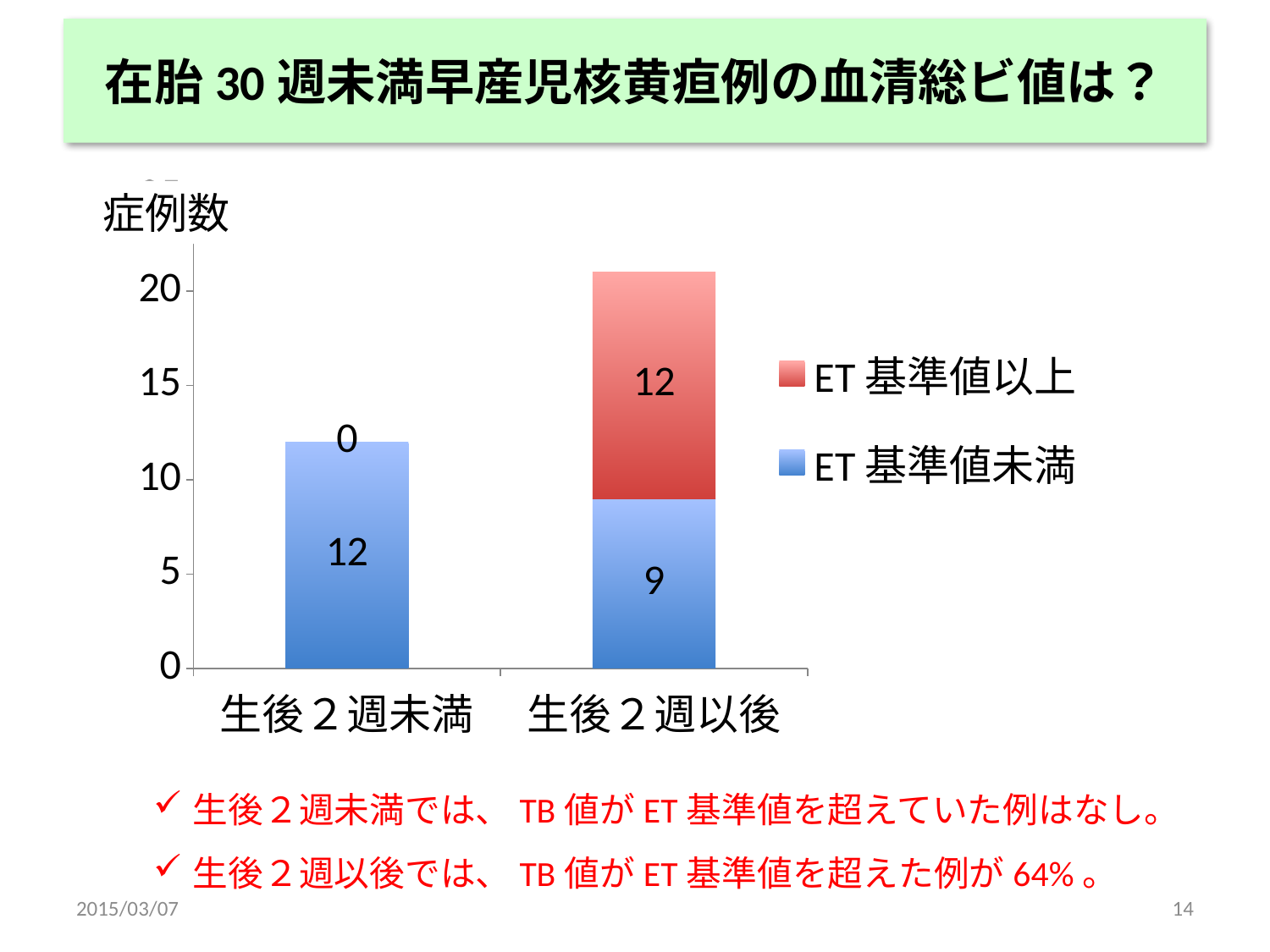
What is the value of ET基準値未満 for 生後２週以後? 9 What is the value of ET基準値以上 for 生後２週以後? 12 What is the total of the stacked bar for 生後２週以後? 21 What is the value of ET基準値未満 for 生後２週未満? 12 How many categories are shown on the x axis? 2 What is the total of the stacked bar for 生後２週未満? 12 Which colour represents ET基準値以上 in the legend? Red What is the difference between the ET基準値未満 values for 生後２週未満 and 生後２週以後? 3 What kind of chart is shown on the slide? Stacked bar chart How many series does the legend list? 2 What is the value of ET基準値以上 for 生後２週未満? 0 Which category has the higher total number of cases, 生後２週未満 or 生後２週以後? 生後２週以後